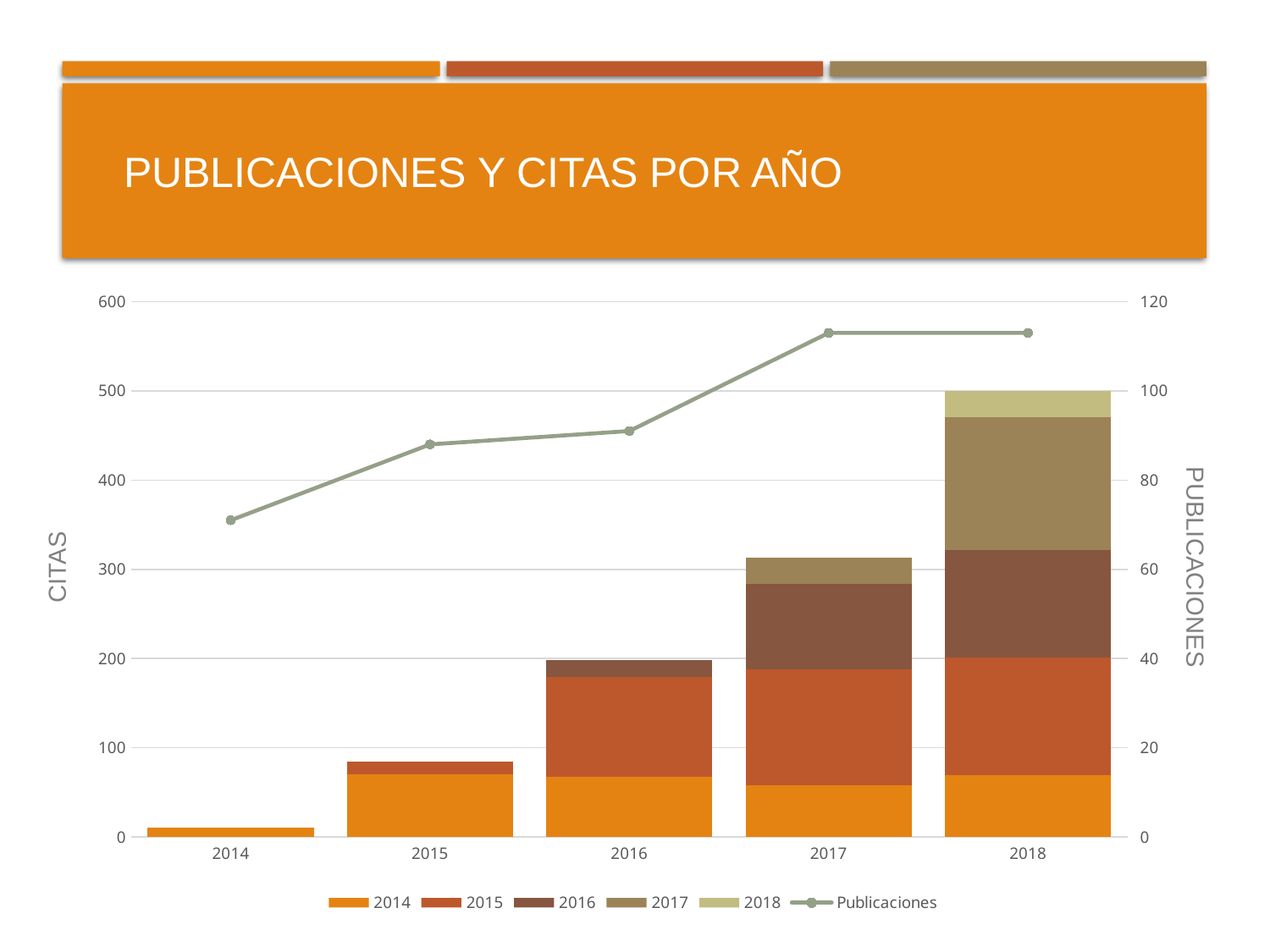
How many years are shown along the x axis? 5 Which year has the shortest stacked bar? 2014 Is the Publicaciones value for 2017 greater or less than 100 on the right axis? greater What is the label of the left vertical axis? CITAS Is the Publicaciones value for 2014 greater or less than 80 on the right axis? less Is the total height of the stacked bar for 2015 greater or less than 100? less Which stacked bar is taller, 2016 or 2017? 2017 Does the Publicaciones line generally rise or fall from 2014 to 2018? rise What kind of chart is shown on the slide? A bar chart with a line How many series does the legend list? 6 Which year has the tallest stacked bar? 2018